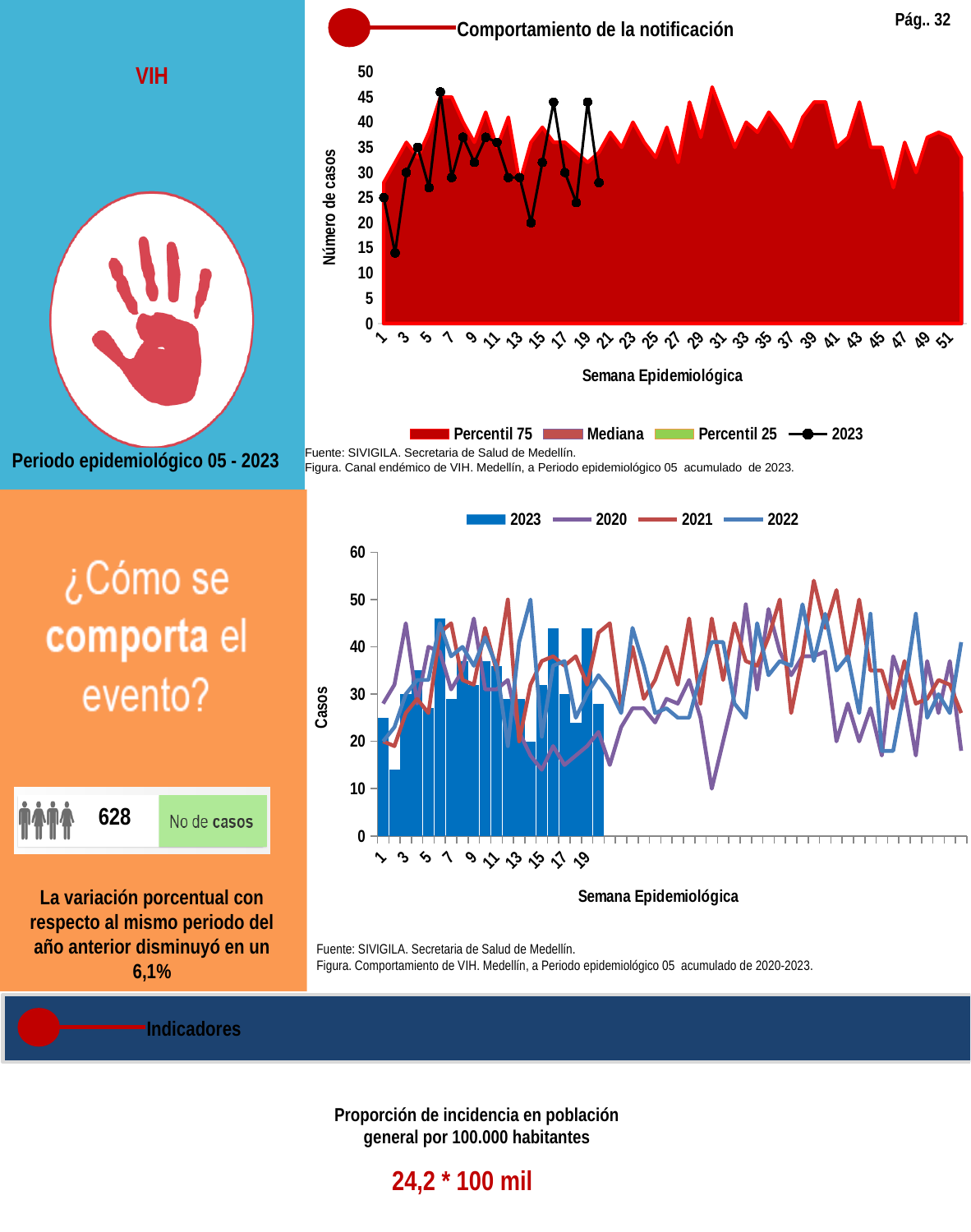
In the top chart 'Comportamiento de la notificación', which week has the lowest value on the 2023 line? Week 2 In the bottom chart, which week has the lowest 2023 bar? Week 2 In the bottom chart, how many series does the legend list? 4 In the bottom chart, which is larger for 2023: week 6 or week 2? Week 6 In the top chart 'Comportamiento de la notificación', is the 2023 value for week 2 greater or less than 20? less In the bottom chart, is the 2023 value for week 16 greater or less than 40? greater In the top chart 'Comportamiento de la notificación', how many series does the legend list? 4 In the top chart 'Comportamiento de la notificación', is the 2023 value for week 6 greater or less than 40? greater In the bottom chart, what kind of chart is used for the 2023 series? bar chart In the top chart 'Comportamiento de la notificación', what is the label of the y axis? Número de casos In the top chart 'Comportamiento de la notificación', how many weeks have a 2023 data point plotted? 20